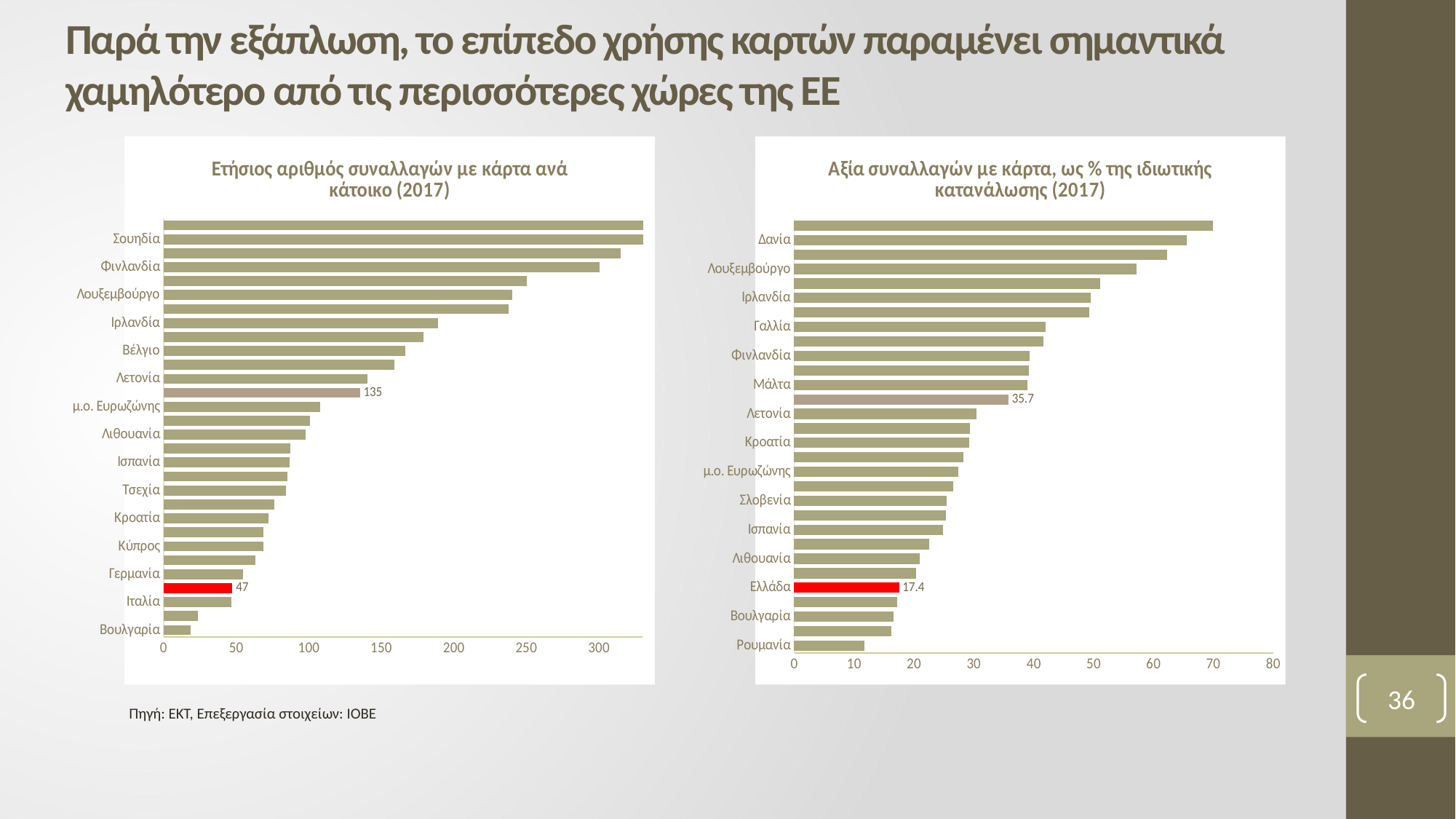
In the left chart, what value is printed on the red bar? 47 In the right chart, what value is printed on the highlighted tan bar? 35.7 In the left chart, is the value for Σουηδία greater or less than 300? greater In the left chart, is the value for Βουλγαρία greater or less than 50? less In the left chart, is the value for Γερμανία greater or less than 100? less In the right chart, what is the difference between the highlighted tan bar (35.7) and Ελλάδα (17.4)? 18.3 What kind of chart is the left chart, 'Ετήσιος αριθμός συναλλαγών με κάρτα ανά κάτοικο (2017)'? Bar chart In the right chart, which is larger, Δανία or Ρουμανία? Δανία In the right chart, 'Αξία συναλλαγών με κάρτα, ως % της ιδιωτικής κατανάλωσης (2017)', what value is printed for Ελλάδα? 17.4